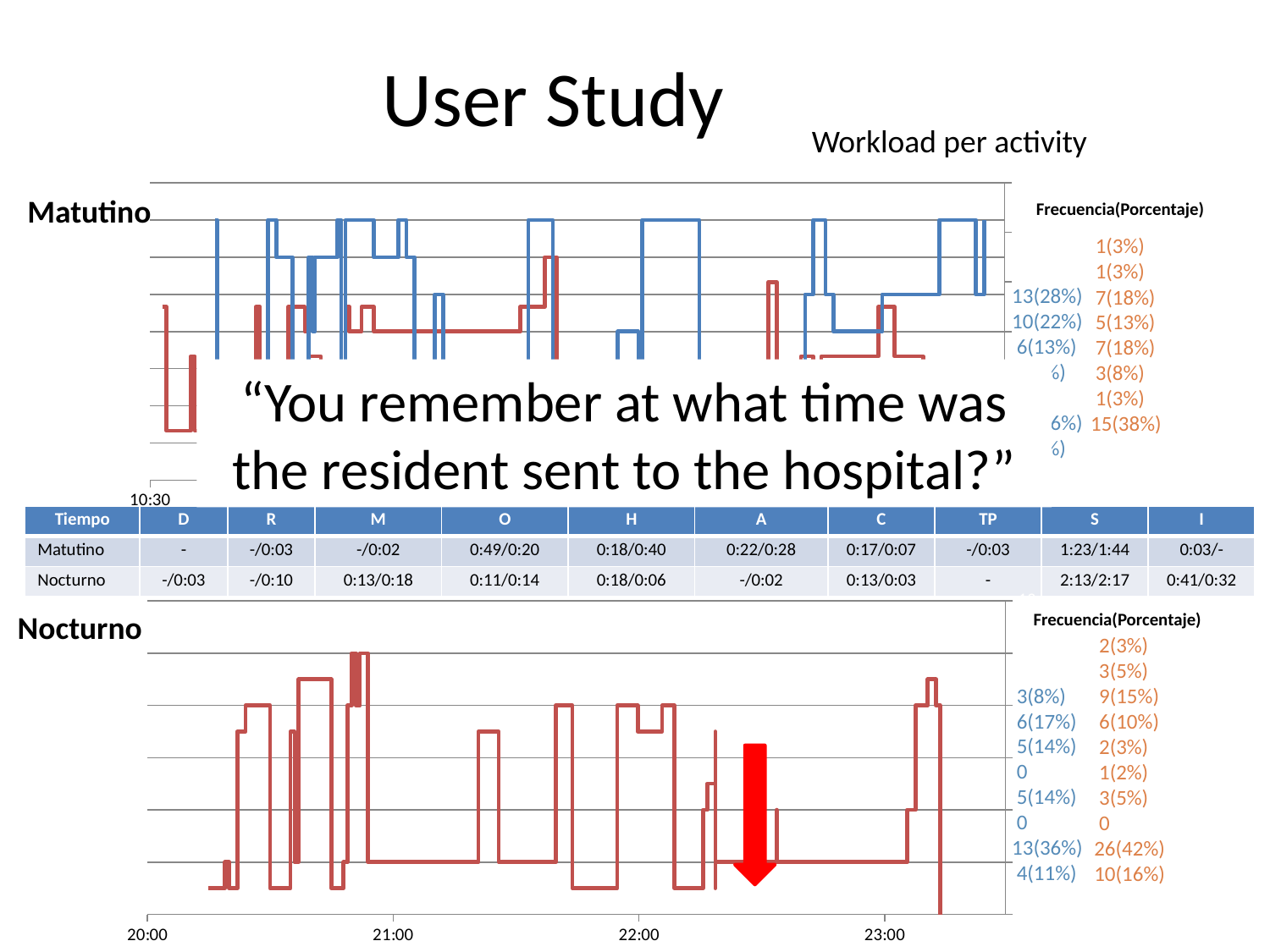
On the Nocturno chart, how many line series are plotted? 1 In the Matutino frequency list on the right, what is the largest frequency value shown? 15(38%) What heading appears above the frequency lists to the right of both charts? Frecuencia(Porcentaje) In the Nocturno frequency list on the right, what is the largest frequency value shown? 26(42%) On the Nocturno chart, what is the last time label on the x axis? 23:00 On the Nocturno chart, how many time labels are shown along the x axis? 4 What kind of chart is the Matutino chart at the top of the slide? line chart What kind of chart is the Nocturno chart at the bottom of the slide? line chart On the Nocturno chart, what is the first time label on the x axis? 20:00 On the Matutino chart, how many differently coloured line series are plotted? 2 What colour is the line plotted on the Nocturno chart? red